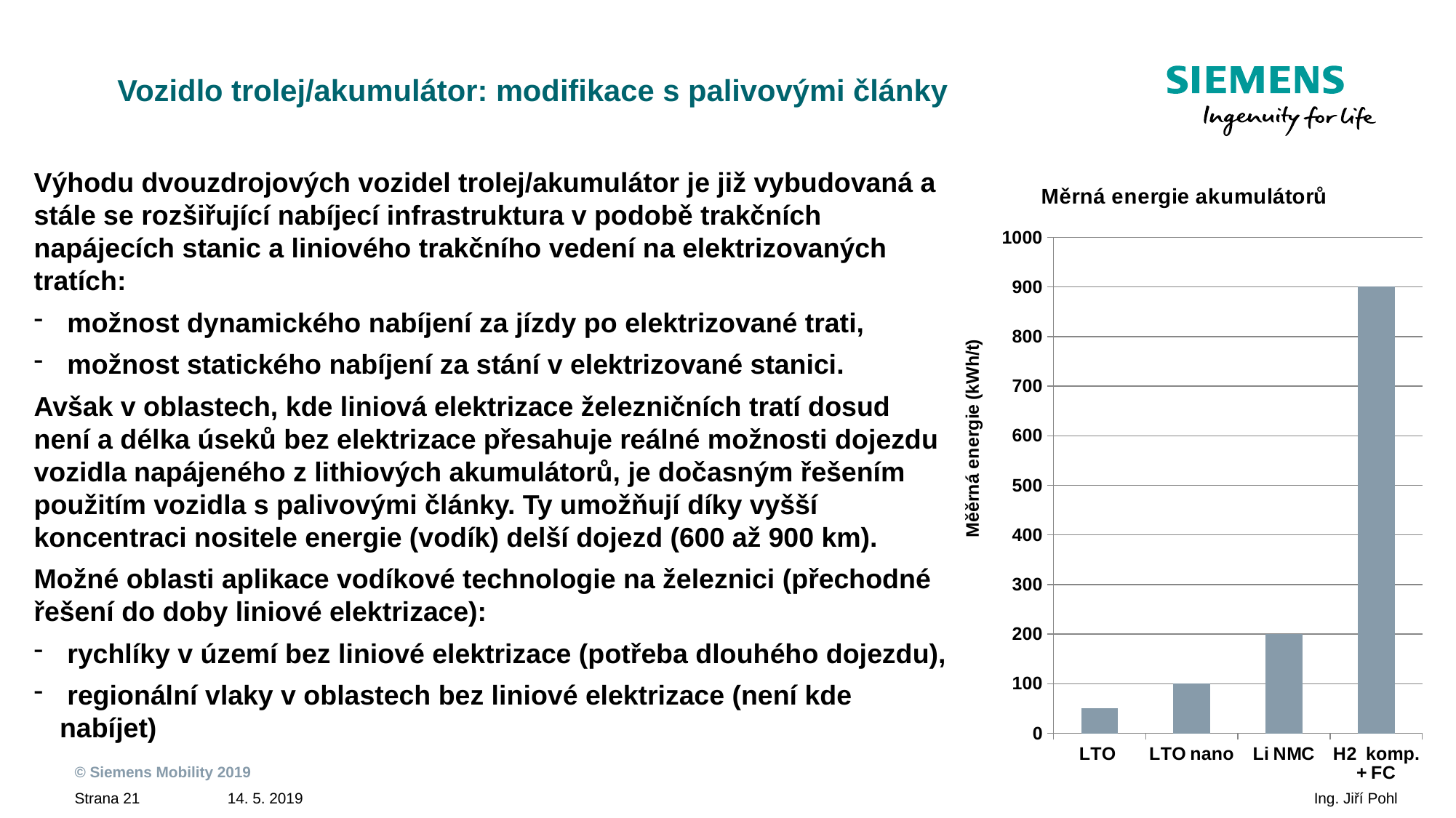
How many categories are shown on the x axis of the chart? 4 What type of chart is shown on the slide? bar chart What is the specific energy value for LTO nano? 100 Which category has the lowest specific energy in the chart? LTO What is the label of the y axis of the chart? Měěrná energie (kWh/t) What is the title of the chart? Měrná energie akumulátorů Is the value for LTO greater or less than 100? less What is the specific energy value for Li NMC? 200 Which category has the highest specific energy in the chart? H2 komp. + FC Which is larger, the value for Li NMC or the value for LTO nano? Li NMC What is the specific energy value for H2 komp. + FC? 900 What is the difference between the values for H2 komp. + FC and Li NMC? 700